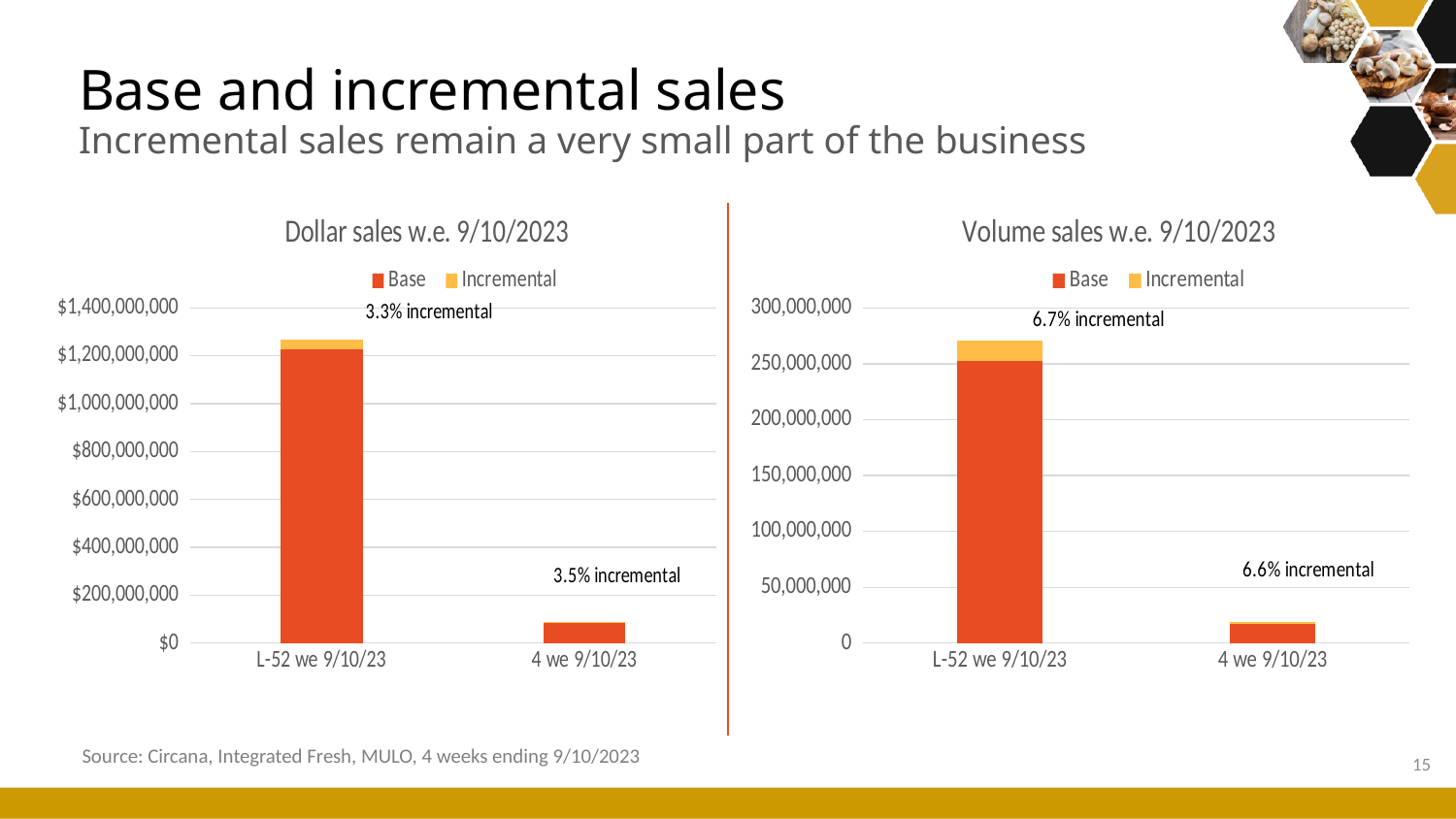
In the 'Volume sales w.e. 9/10/2023' chart, what incremental percentage is labelled for 4 we 9/10/23? 6.6% incremental How many categories are shown on the x axis of the 'Volume sales w.e. 9/10/2023' chart? 2 What kind of chart is the 'Dollar sales w.e. 9/10/2023' chart? Stacked bar chart In the 'Volume sales w.e. 9/10/2023' chart, which category has the taller bar, L-52 we 9/10/23 or 4 we 9/10/23? L-52 we 9/10/23 In the 'Dollar sales w.e. 9/10/2023' chart, is the value for 4 we 9/10/23 greater or less than $200,000,000? less In the 'Volume sales w.e. 9/10/2023' chart, is the total value for L-52 we 9/10/23 greater or less than 300,000,000? less In the 'Dollar sales w.e. 9/10/2023' chart, what incremental percentage is labelled for 4 we 9/10/23? 3.5% incremental How many series does the legend of the 'Volume sales w.e. 9/10/2023' chart list? 2 In the 'Dollar sales w.e. 9/10/2023' chart, what incremental percentage is labelled for L-52 we 9/10/23? 3.3% incremental In the 'Dollar sales w.e. 9/10/2023' chart, is the total value for L-52 we 9/10/23 greater or less than $1,000,000,000? greater What are the two series named in the legend of the 'Dollar sales w.e. 9/10/2023' chart? Base and Incremental In the 'Volume sales w.e. 9/10/2023' chart, what incremental percentage is labelled for L-52 we 9/10/23? 6.7% incremental